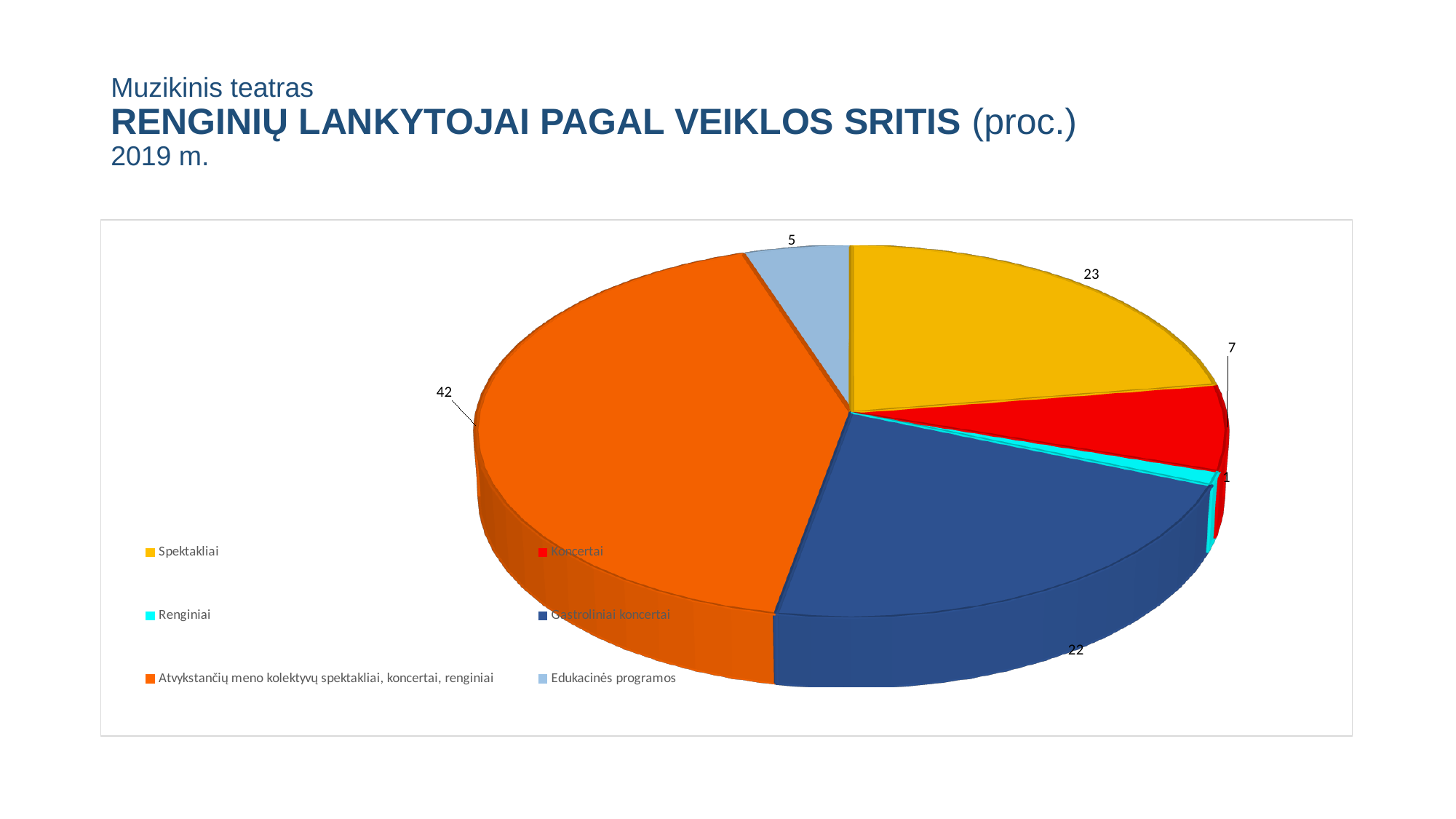
What is the value for Gastroliniai koncertai? 22 Which category has the largest slice of the pie? Atvykstančių meno kolektyvų spektakliai, koncertai, renginiai What is the value for Renginiai? 1 Which is larger, the value for Koncertai or the value for Edukacinės programos? Koncertai What is the value for Koncertai? 7 What is the value for Spektakliai? 23 What colour is the slice for Gastroliniai koncertai? Dark blue What is the value for Edukacinės programos? 5 Which category has the smallest slice of the pie? Renginiai What is the difference between the values for Atvykstančių meno kolektyvų spektakliai, koncertai, renginiai and Spektakliai? 19 What type of chart is shown on the slide? Pie chart How many categories does the pie chart have? 6